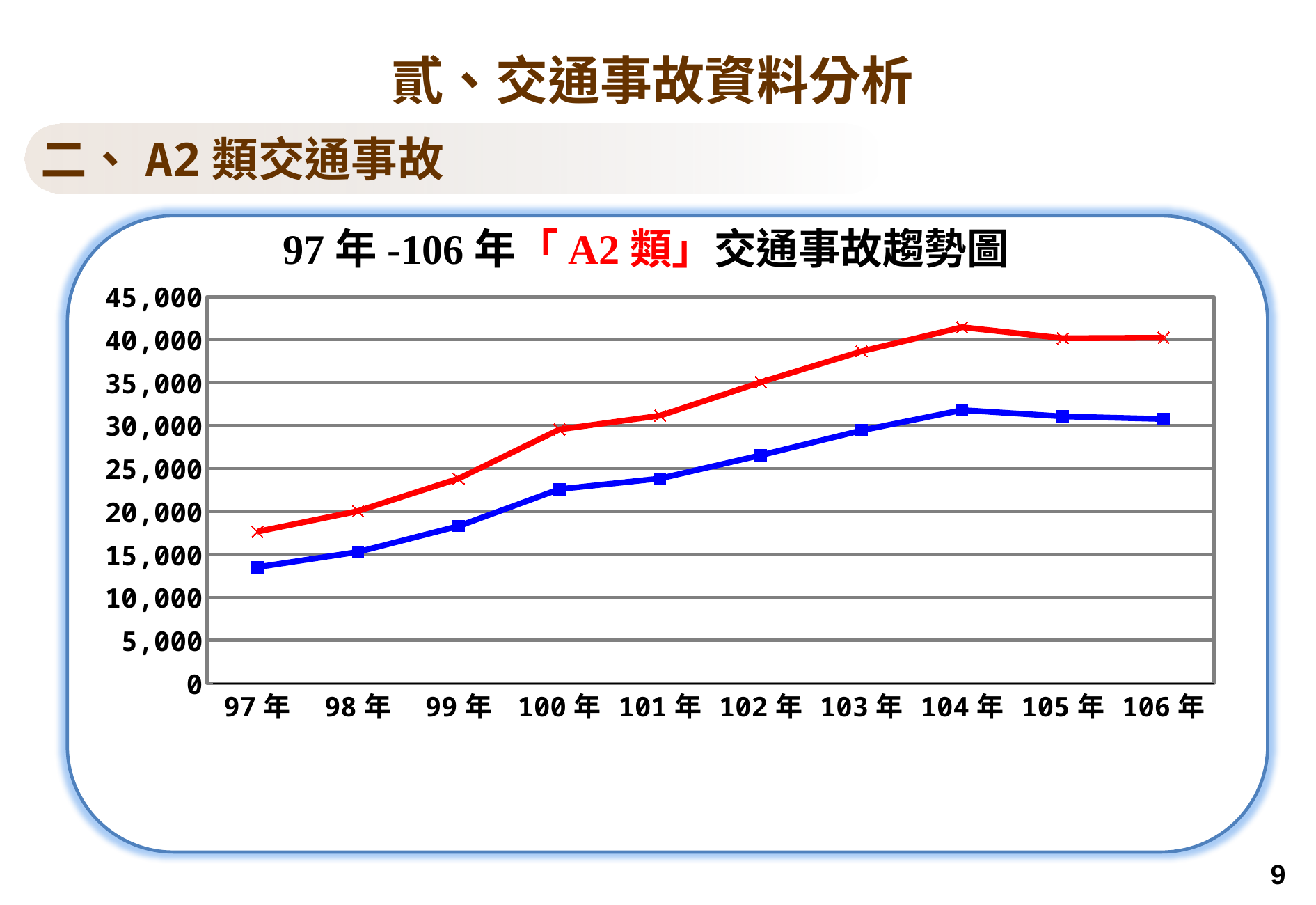
In which year does the red line reach its highest value? 104年 Which line has the higher value in 103年, the red line or the blue line? The red line Is the value of the blue line for 102年 greater or less than 25,000? greater What is the title of the chart? 97年-106年「A2類」交通事故趨勢圖 In which year does the blue line reach its lowest value? 97年 How many lines (data series) are plotted on the chart? 2 Is the value of the red line for 97年 greater or less than 20,000? less How many years (data points) are shown along the x axis of the chart? 10 Is the value of the blue line for 97年 greater or less than 15,000? less What kind of chart is shown on the slide? Line chart Do the values of the blue line rise or fall from 97年 to 104年? Rise